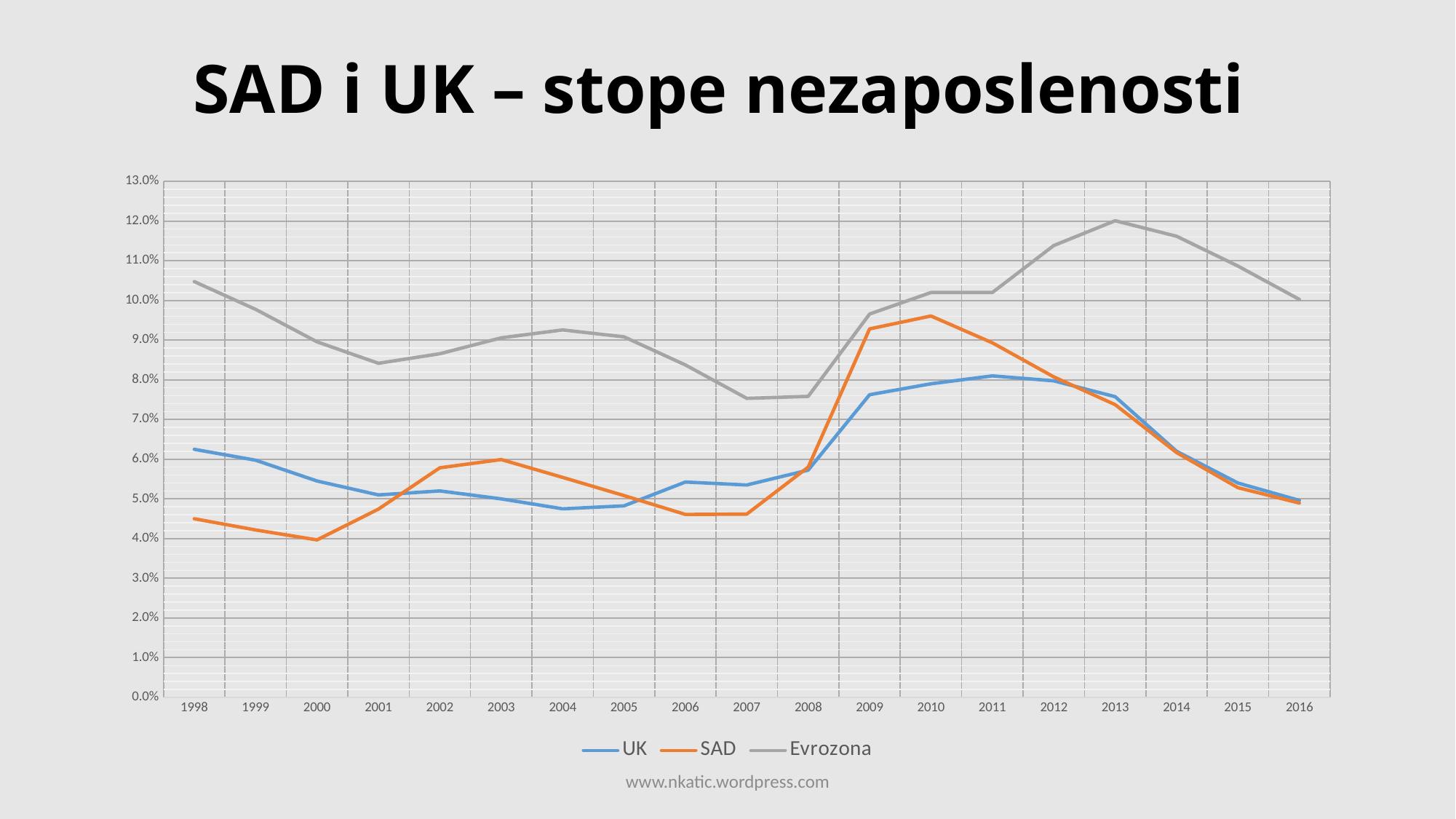
In which year does the Evrozona series reach its highest value? 2013 In which year does the UK series reach its highest value? 2011 What kind of chart is shown on the slide? line chart How many years are plotted along the x axis? 19 Is the value for Evrozona in 1998 greater or less than 10.0%? greater In 2009, which series has the higher value, UK or SAD? SAD Does the Evrozona series rise or fall from 2013 to 2016? fall How many series does the legend list? 3 Is the value for SAD in 2009 greater or less than 9.0%? greater Is the value for UK in 2004 greater or less than 5.0%? less In which year does the SAD series reach its highest value? 2010 In which year does the SAD series reach its lowest value? 2000